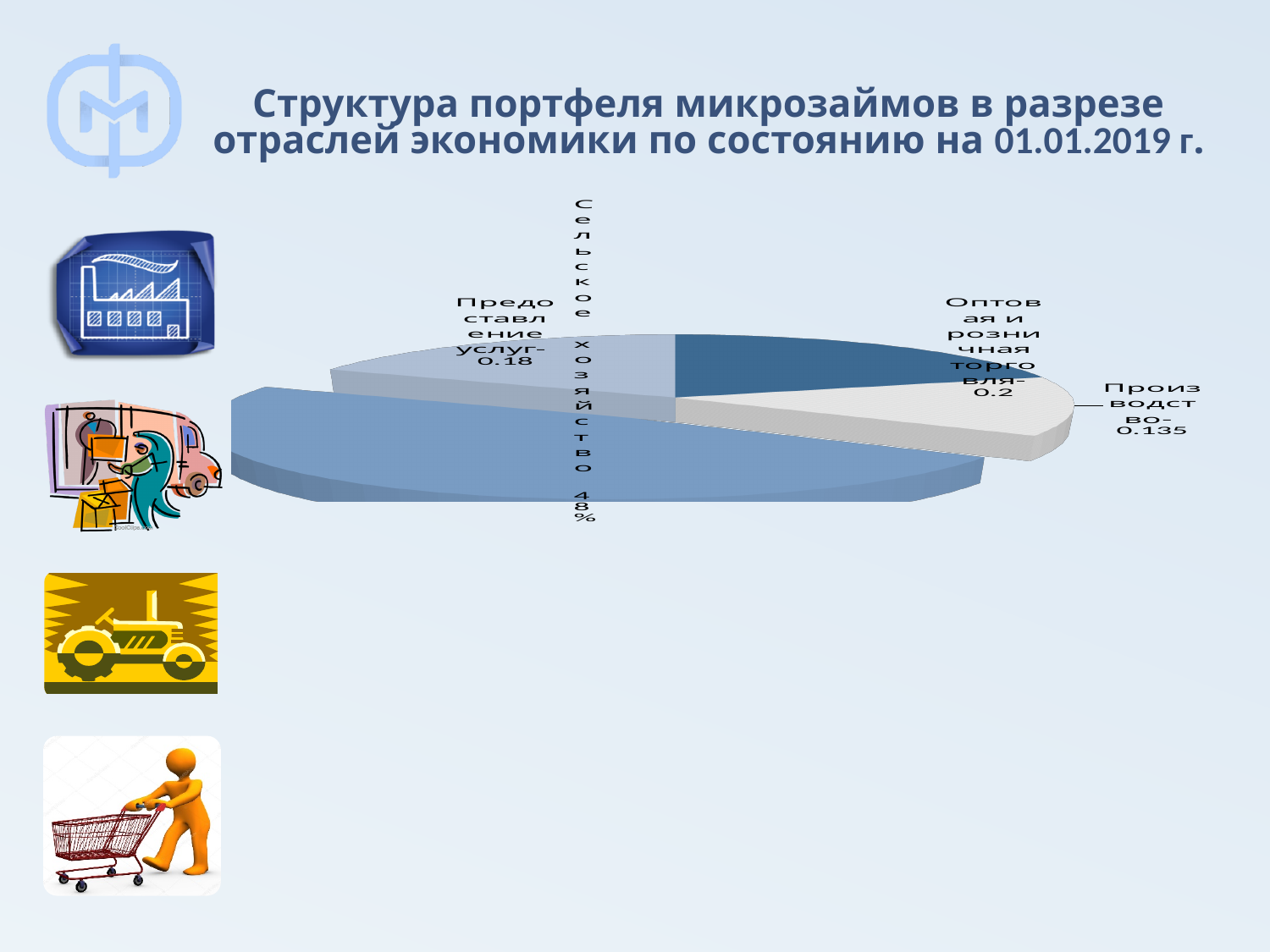
What is the difference between the values for Предоставление услуг and Производство? 0.045 What is the difference between the values for Оптовая и розничная торговля and Предоставление услуг? 0.02 What kind of chart is shown on the slide? Pie chart What is the title of the chart on the slide? Структура портфеля микрозаймов в разрезе отраслей экономики по состоянию на 01.01.2019 г. Which is larger: Оптовая и розничная торговля or Предоставление услуг? Оптовая и розничная торговля Which sector has the largest slice of the pie? Сельское хозяйство How many slices does the pie chart have? 4 What value is shown for Оптовая и розничная торговля? 0.2 What value is shown for Сельское хозяйство? 48% Which sector has the smallest slice of the pie? Производство What value is shown for Предоставление услуг? 0.18 What value is shown for Производство? 0.135